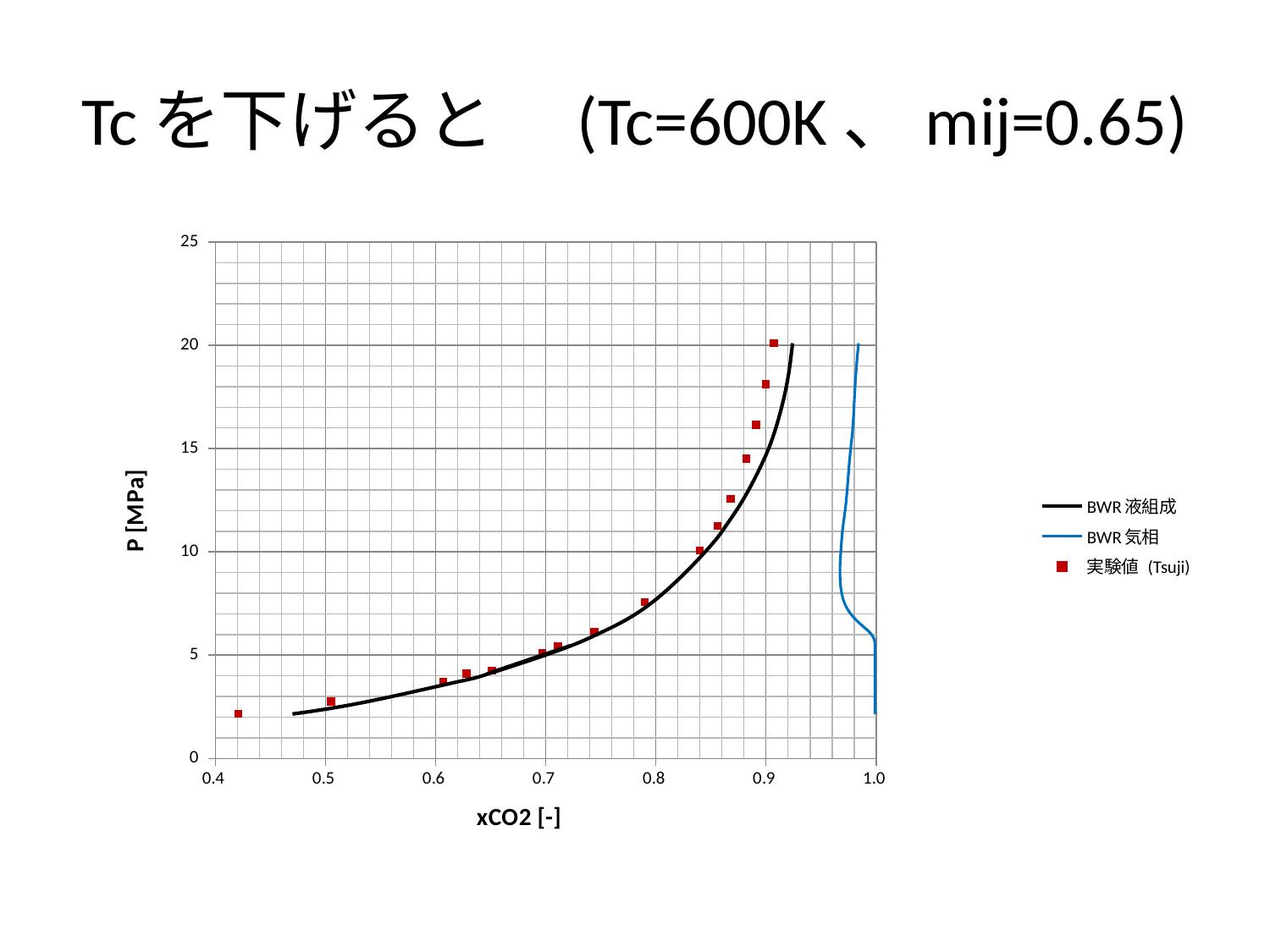
At P = 10 MPa, which curve has the larger xCO2 value, BWR 液組成 or BWR 気相? BWR 気相 What kind of chart is shown on the slide? line chart with scatter points Is the pressure of the highest 実験値 (Tsuji) point greater or less than 15 MPa? greater Along the BWR 液組成 curve, does P rise or fall as xCO2 increases? rise Which series has the highest xCO2 values on the chart? BWR 気相 Is the xCO2 value of the BWR 気相 curve greater or less than 0.9 throughout? greater Is the pressure of the leftmost 実験値 (Tsuji) point greater or less than 5 MPa? less How many series does the legend list? 3 What are the three series named in the legend? BWR 液組成, BWR 気相, 実験値 (Tsuji) What is the label of the x axis? xCO2 [-]